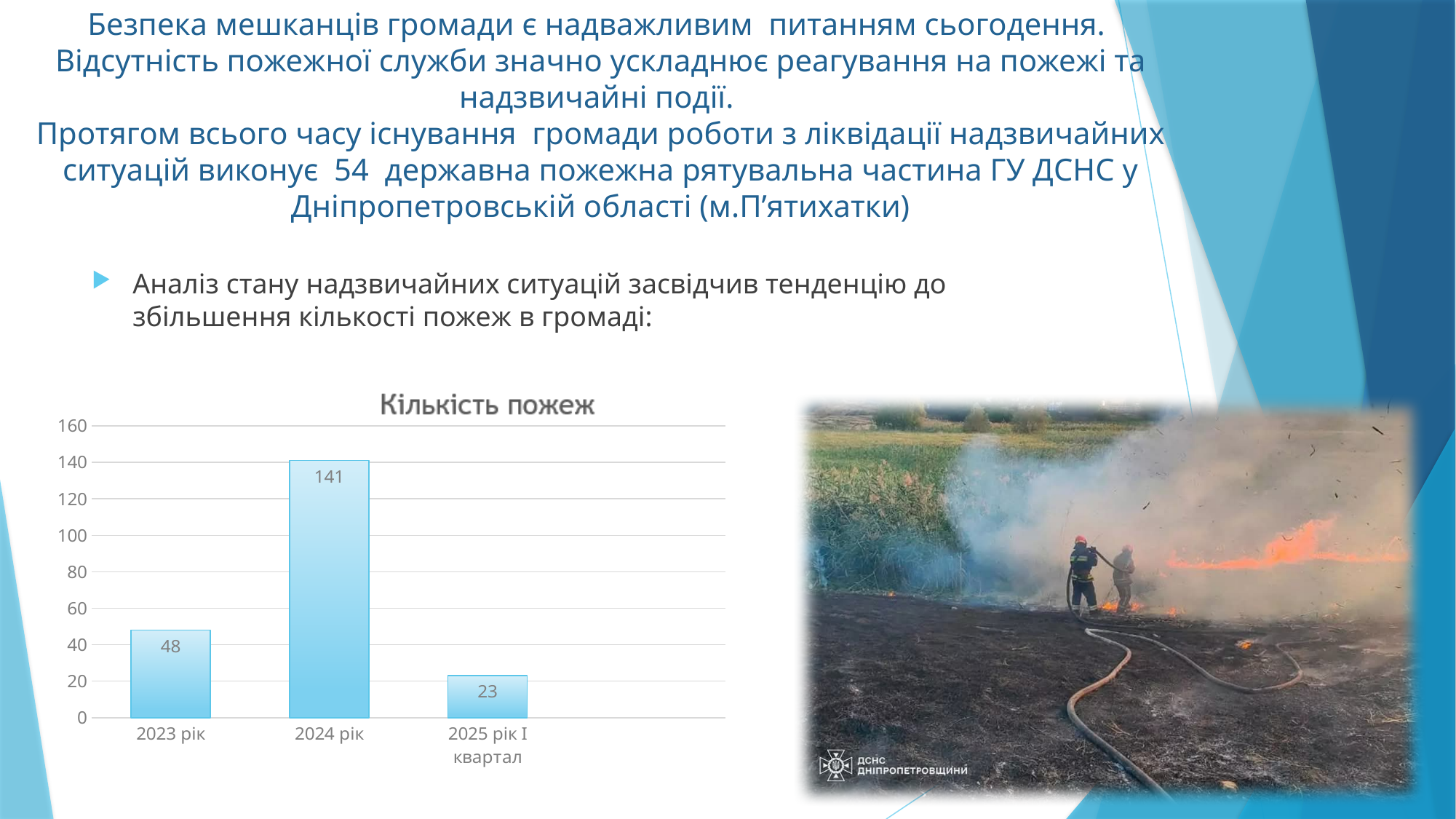
What is the difference between the values for 2024 рік and 2023 рік? 93 How many categories are shown in the chart? 3 What kind of chart is shown on the slide? bar chart What is the difference between the values for 2023 рік and 2025 рік I квартал? 25 What is the value for 2025 рік I квартал in the chart? 23 Which category has the lowest value in the chart? 2025 рік I квартал What is the value for 2023 рік in the chart? 48 Which category has the highest value in the chart? 2024 рік Which is larger, the value for 2023 рік or the value for 2025 рік I квартал? 2023 рік What is the value for 2024 рік in the chart? 141 Is the value for 2024 рік greater or less than 100? greater What is the title of the chart? Кількість пожеж